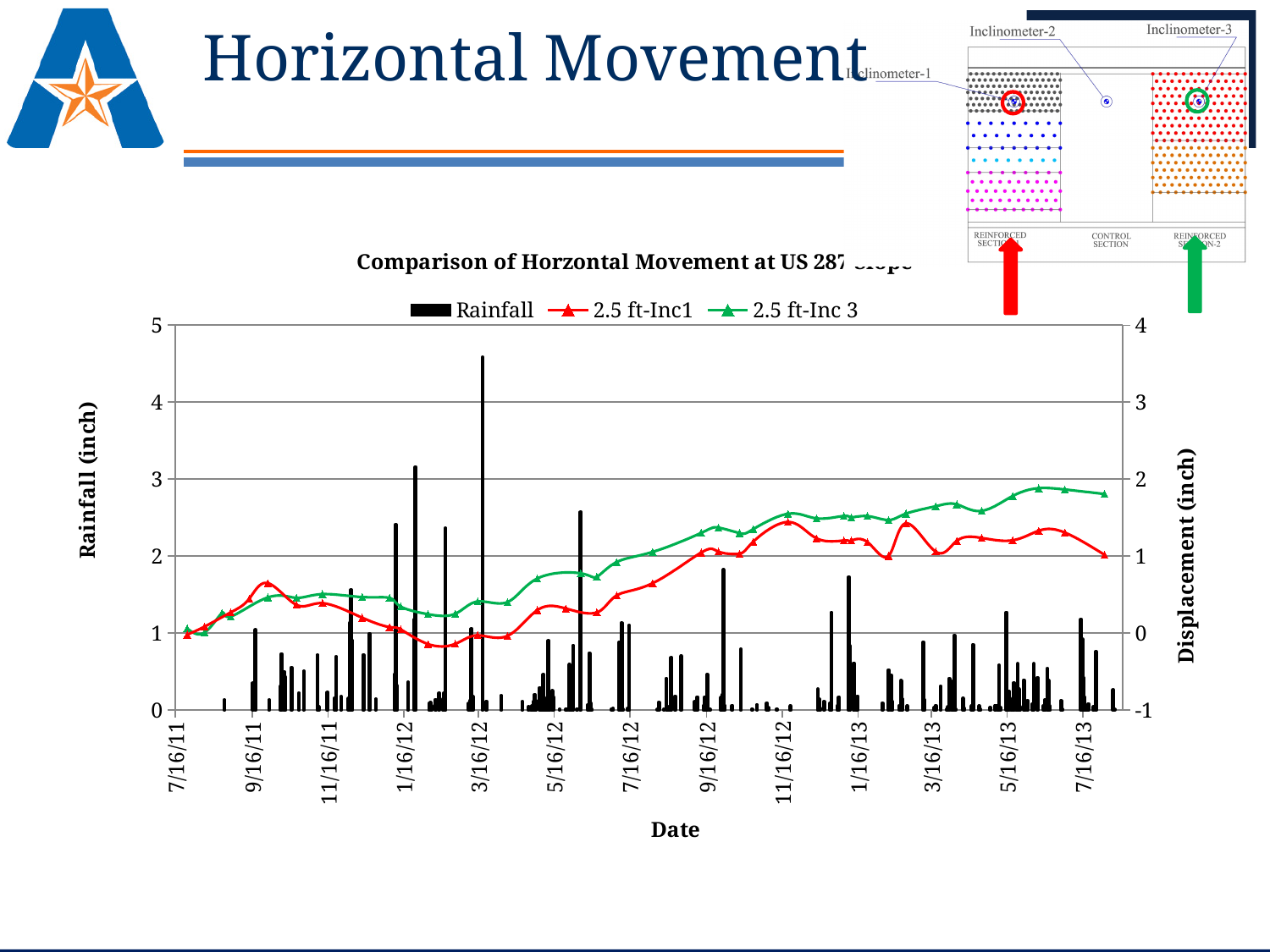
How many series does the chart legend list? 3 What kind of chart is shown on the slide? Combination bar and line chart Is the peak displacement of 2.5 ft-Inc1 greater or less than 2 inches? less What are the three series named in the chart legend? Rainfall, 2.5 ft-Inc1, 2.5 ft-Inc 3 Is the displacement for 2.5 ft-Inc1 at 9/16/11 greater or less than 1 inch? less At 7/16/13, which series shows the larger displacement, 2.5 ft-Inc1 or 2.5 ft-Inc 3? 2.5 ft-Inc 3 Which displacement series reaches the highest value on the chart? 2.5 ft-Inc 3 Is the displacement for 2.5 ft-Inc 3 at 1/16/13 greater or less than 1 inch? greater Does the displacement for 2.5 ft-Inc 3 generally rise or fall from 7/16/11 to 7/16/13? rise What is the title of the left vertical axis of the chart? Rainfall (inch)